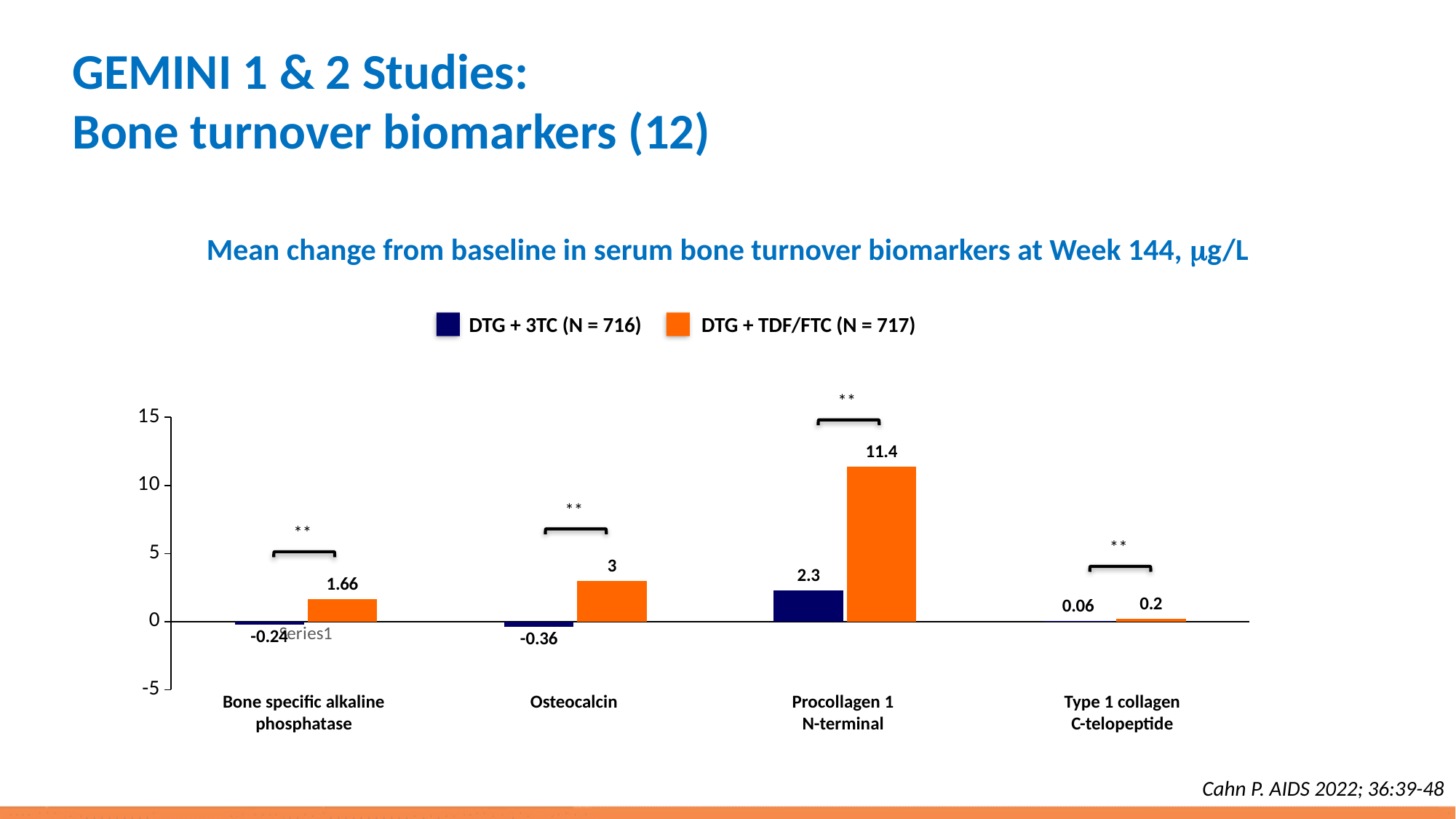
What is the difference between the DTG + TDF/FTC and DTG + 3TC values for Procollagen 1 N-terminal? 9.1 What is the mean change from baseline for DTG + 3TC in Osteocalcin? -0.36 What kind of chart is shown on the slide? Bar chart Is the DTG + TDF/FTC value for Procollagen 1 N-terminal greater or less than 10? greater How many series does the legend list? 2 What is the value for DTG + 3TC in Type 1 collagen C-telopeptide? 0.06 Which biomarker has the lowest value for DTG + 3TC? Osteocalcin What is the mean change from baseline for DTG + TDF/FTC in Procollagen 1 N-terminal? 11.4 What is the value for DTG + TDF/FTC in Bone specific alkaline phosphatase? 1.66 How many biomarker categories are shown on the x axis? 4 Which biomarker has the highest value for DTG + TDF/FTC? Procollagen 1 N-terminal For Osteocalcin, which arm has the larger value, DTG + 3TC or DTG + TDF/FTC? DTG + TDF/FTC